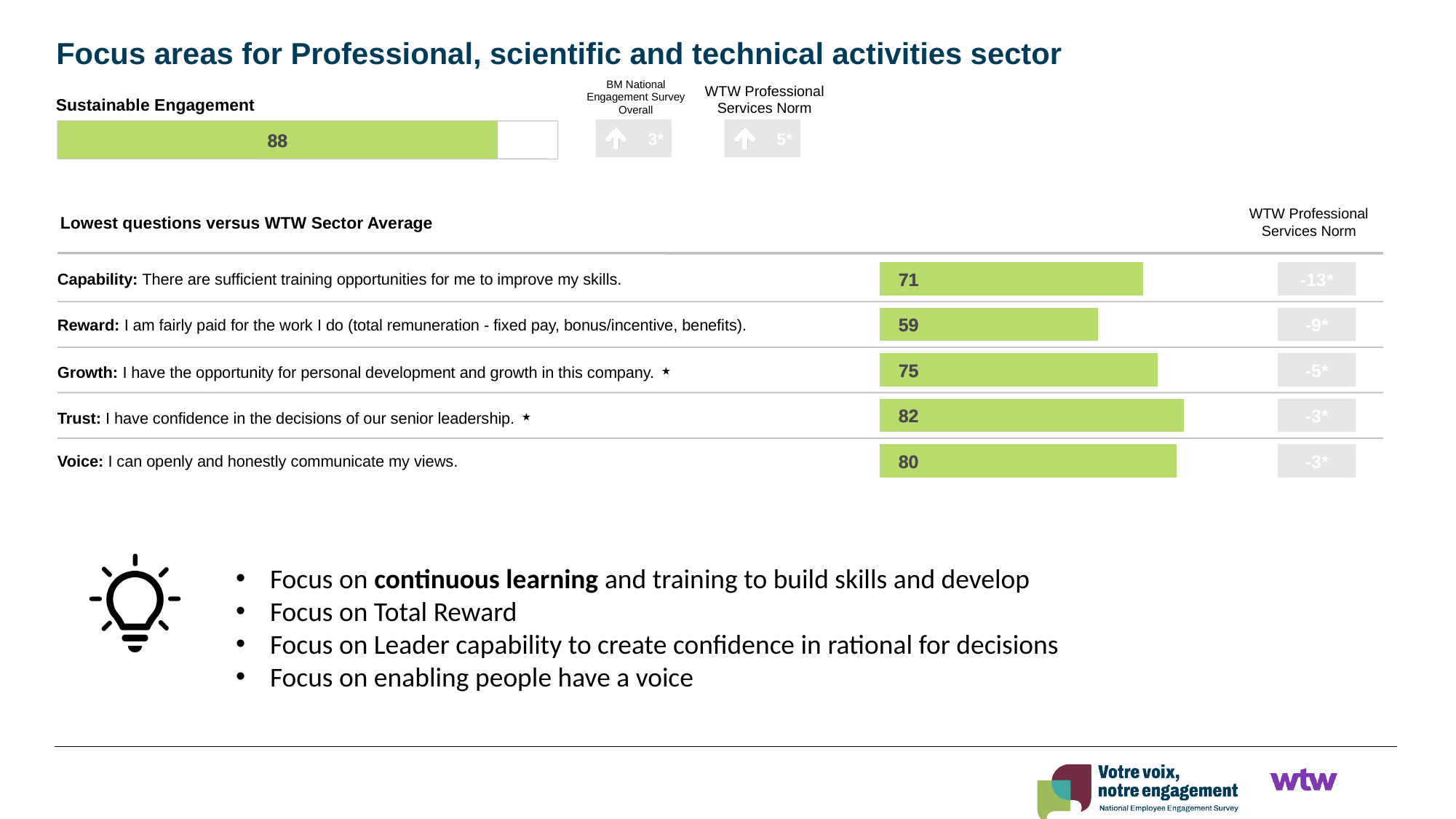
In the Sustainable Engagement section, what is the value shown against the WTW Professional Services Norm? 5* In the Sustainable Engagement section, what is the value shown against the BM National Engagement Survey Overall? 3* In the Lowest questions versus WTW Sector Average chart, which question has the highest score? Trust In the Lowest questions versus WTW Sector Average chart, what is the score for the Capability question? 71 In the Lowest questions versus WTW Sector Average chart, what is the WTW Professional Services Norm difference shown for the Capability question? -13* In the Lowest questions versus WTW Sector Average chart, which has the higher score, Growth or Voice? Voice How many questions are listed in the Lowest questions versus WTW Sector Average chart? 5 In the Lowest questions versus WTW Sector Average chart, what is the difference between the Trust score and the Reward score? 23 In the Sustainable Engagement bar at the top of the slide, what score is shown? 88 In the Lowest questions versus WTW Sector Average chart, which question has the lowest score? Reward What kind of chart is used to show the scores in the Lowest questions versus WTW Sector Average section? Bar chart In the Lowest questions versus WTW Sector Average chart, what is the score for the Reward question? 59